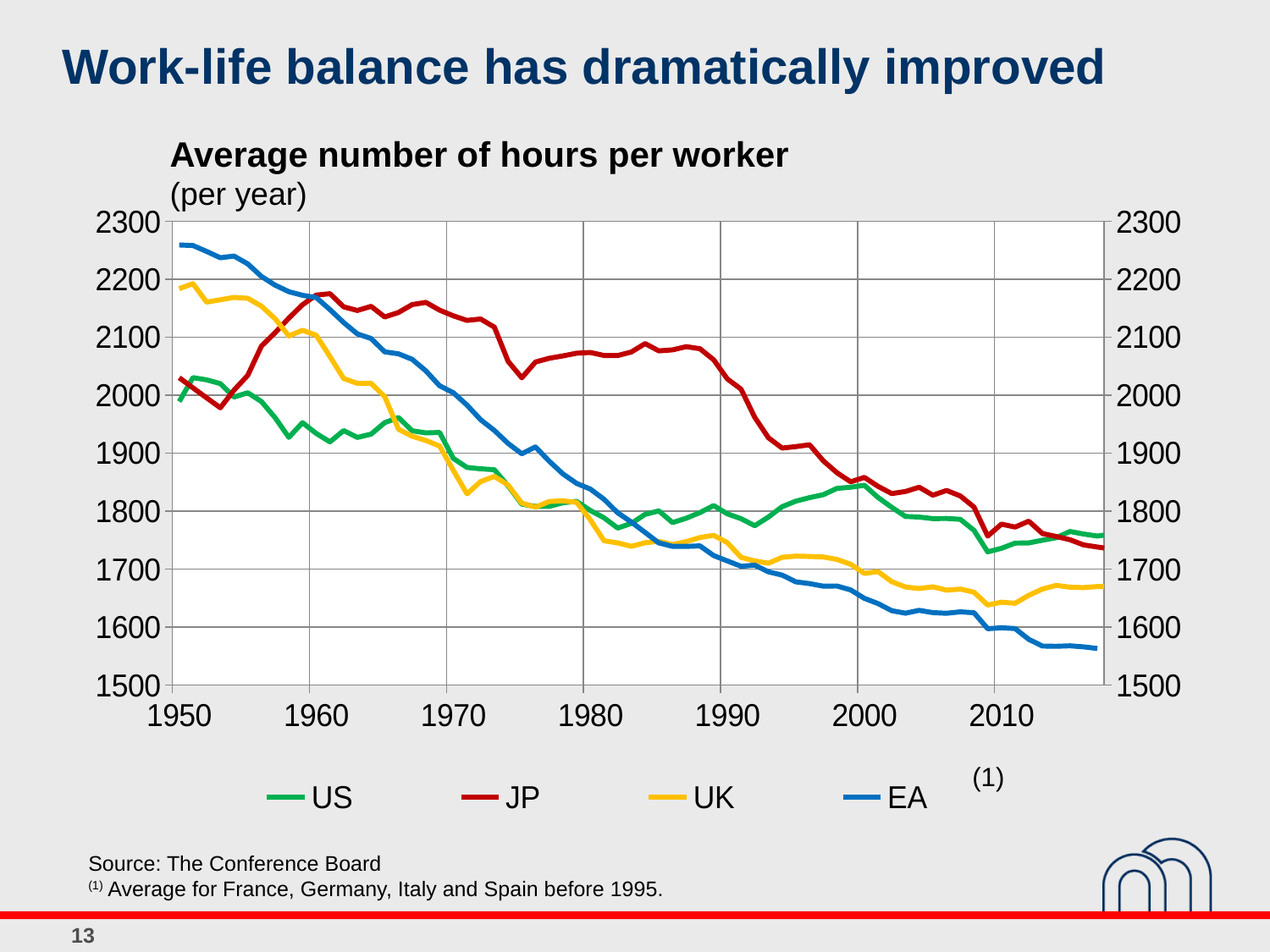
Which series has the lowest value in 2010? EA How many series does the legend list? 4 Is the value for EA in 2000 greater or less than 1700? less Is the value for UK in 2010 greater or less than 1700? less Which series has the highest value in 1950? EA Is the value for JP in 1960 greater or less than 2100? greater In 2010, which series has the larger value, JP or EA? JP What kind of chart is shown on the slide? line chart What is the title of the chart? Average number of hours per worker (per year) Does the EA series rise or fall from 1950 to the end of the period? fall